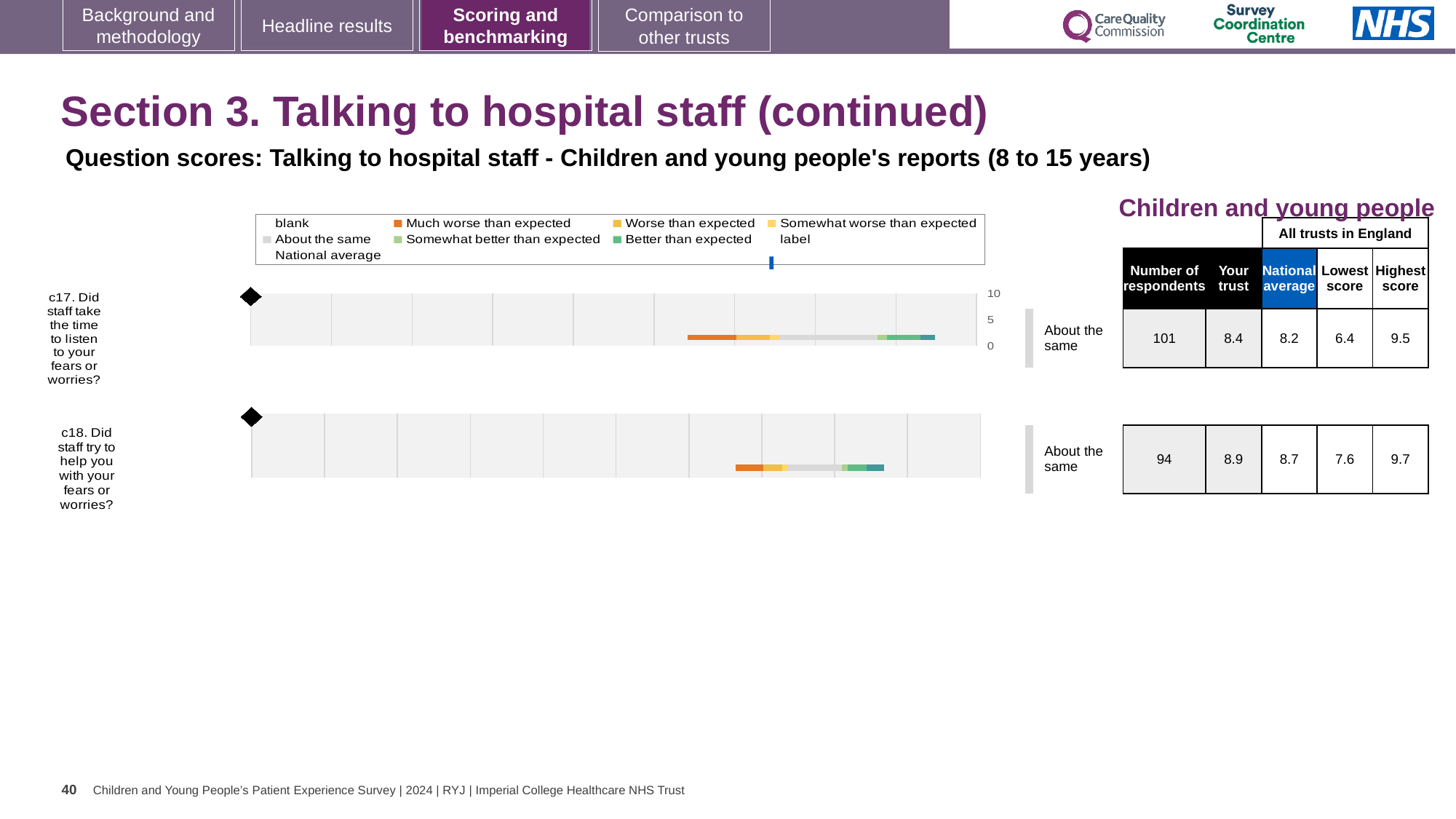
How many questions are plotted on the slide? 2 What is the highest score among all trusts in England for question c18? 9.7 Which question has the higher 'Your trust' score, c17 or c18? c18 Which colour in the legend represents 'Much worse than expected'? Orange What is the lowest score among all trusts in England for question c17? 6.4 By how much does the trust's score for question c18 exceed the national average? 0.2 What is the 'Your trust' score for question c17 (Did staff take the time to listen to your fears or worries?)? 8.4 What type of chart is used to show the question scores? Bar chart What is the difference between the highest and lowest scores for question c17? 3.1 What benchmark category is the trust's result for question c17 placed in? About the same How many respondents answered question c17? 101 What is the national average score for question c18 (Did staff try to help you with your fears or worries?)? 8.7